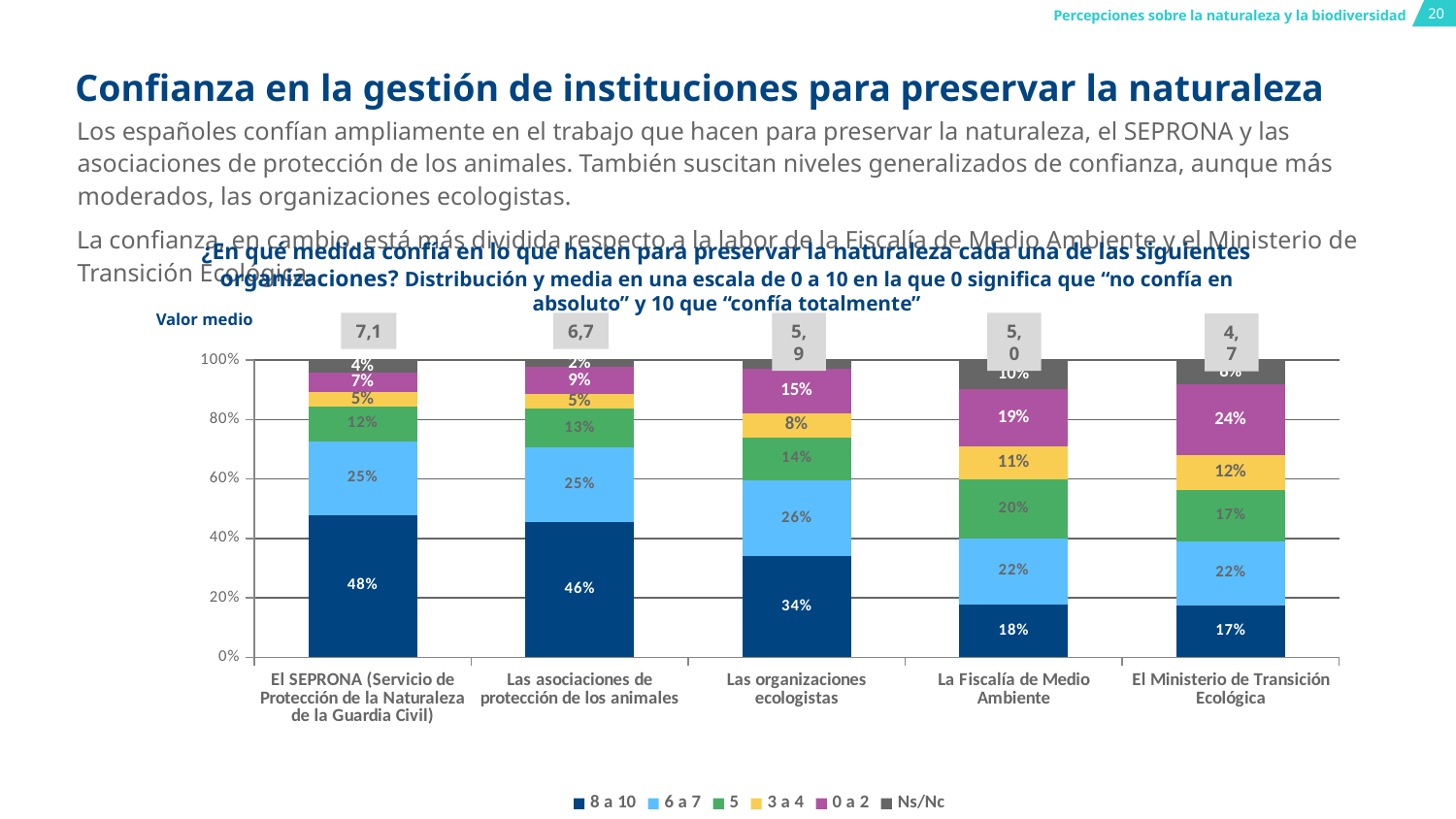
What kind of chart is shown on the slide? Stacked bar chart How many institutions are shown on the x axis of the chart? 5 Which institution has the lowest share of respondents scoring 8 a 10? El Ministerio de Transición Ecológica How many series does the legend list? 6 Which institution has the highest share of respondents scoring 8 a 10? El SEPRONA (Servicio de Protección de la Naturaleza de la Guardia Civil) What is the 'Valor medio' shown above the bar for Las organizaciones ecologistas? 5,9 What is the difference in percentage points between the 8 a 10 share for El SEPRONA and for Las asociaciones de protección de los animales? 2 percentage points Does the 8 a 10 share rise or fall moving from left to right across the institutions? Falls What percentage of respondents gave a score of 6 a 7 for La Fiscalía de Medio Ambiente? 22% What percentage of respondents gave a score of 0 a 2 for El Ministerio de Transición Ecológica? 24% Which has a larger 0 a 2 share: La Fiscalía de Medio Ambiente or El Ministerio de Transición Ecológica? El Ministerio de Transición Ecológica What percentage of respondents gave a score of 8 a 10 for El SEPRONA (Servicio de Protección de la Naturaleza de la Guardia Civil)? 48%